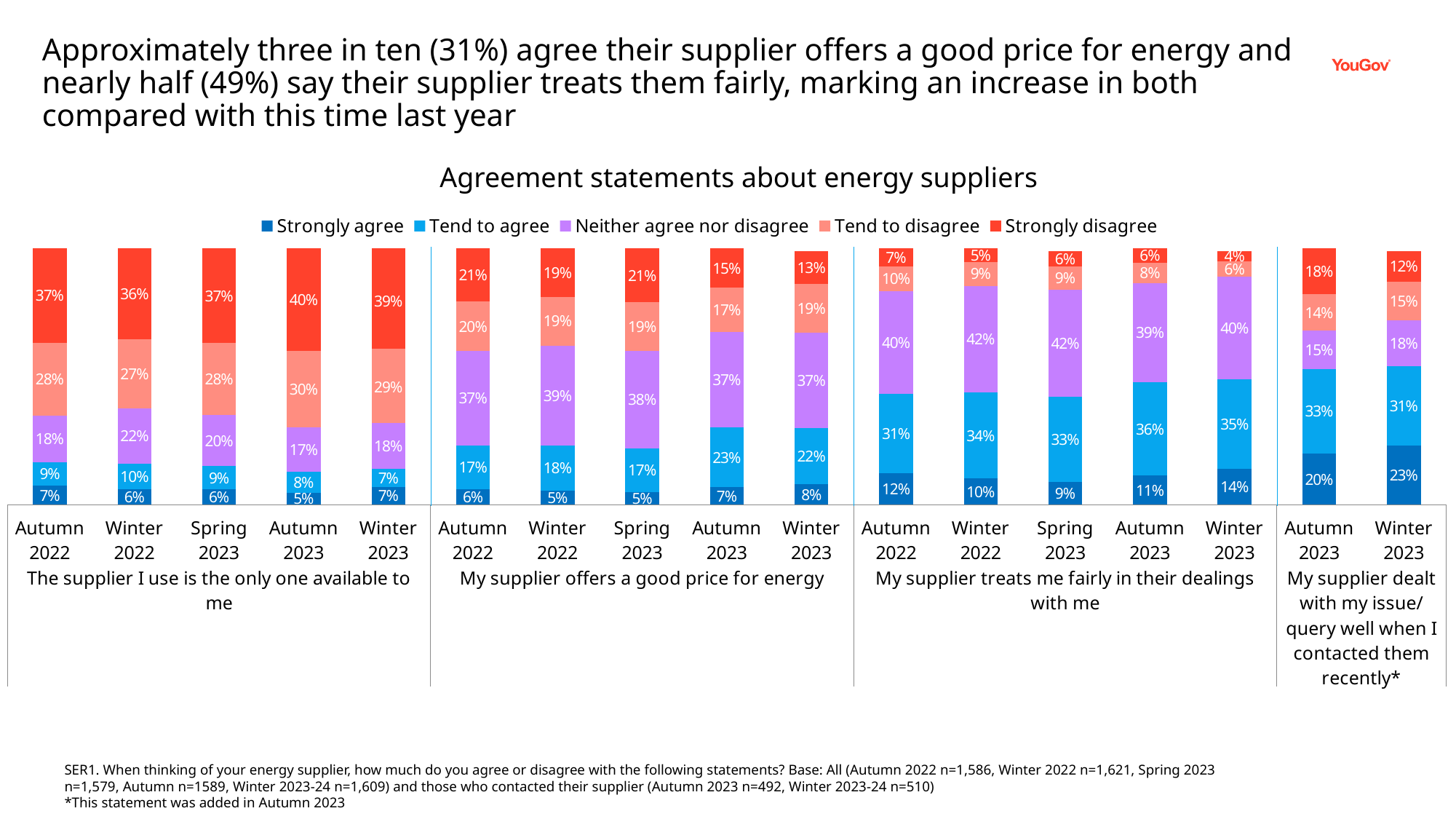
What is the 'Strongly disagree' value for Autumn 2023 under 'The supplier I use is the only one available to me'? 40% What is the difference between the 'Strongly disagree' values for Autumn 2023 and Winter 2023 under 'My supplier dealt with my issue/query well when I contacted them recently'? 6% What is the 'Neither agree nor disagree' value for Spring 2023 under 'My supplier treats me fairly in their dealings with me'? 42% What is the 'Tend to agree' value for Winter 2023 under 'My supplier offers a good price for energy'? 22% Under 'My supplier offers a good price for energy', is the 'Tend to agree' value larger for Autumn 2022 or Autumn 2023? Autumn 2023 How many series does the legend list? 5 What type of chart is shown on the slide? Stacked bar chart What is the combined 'Strongly agree' and 'Tend to agree' total for Winter 2023 under 'My supplier treats me fairly in their dealings with me'? 49% What is the 'Strongly agree' value for Winter 2023 under 'My supplier dealt with my issue/query well when I contacted them recently'? 23% How many bars are shown under 'My supplier dealt with my issue/query well when I contacted them recently'? 2 Under 'My supplier offers a good price for energy', which wave has the lowest 'Strongly disagree' value? Winter 2023 Under 'My supplier treats me fairly in their dealings with me', which wave has the highest 'Strongly agree' value? Winter 2023